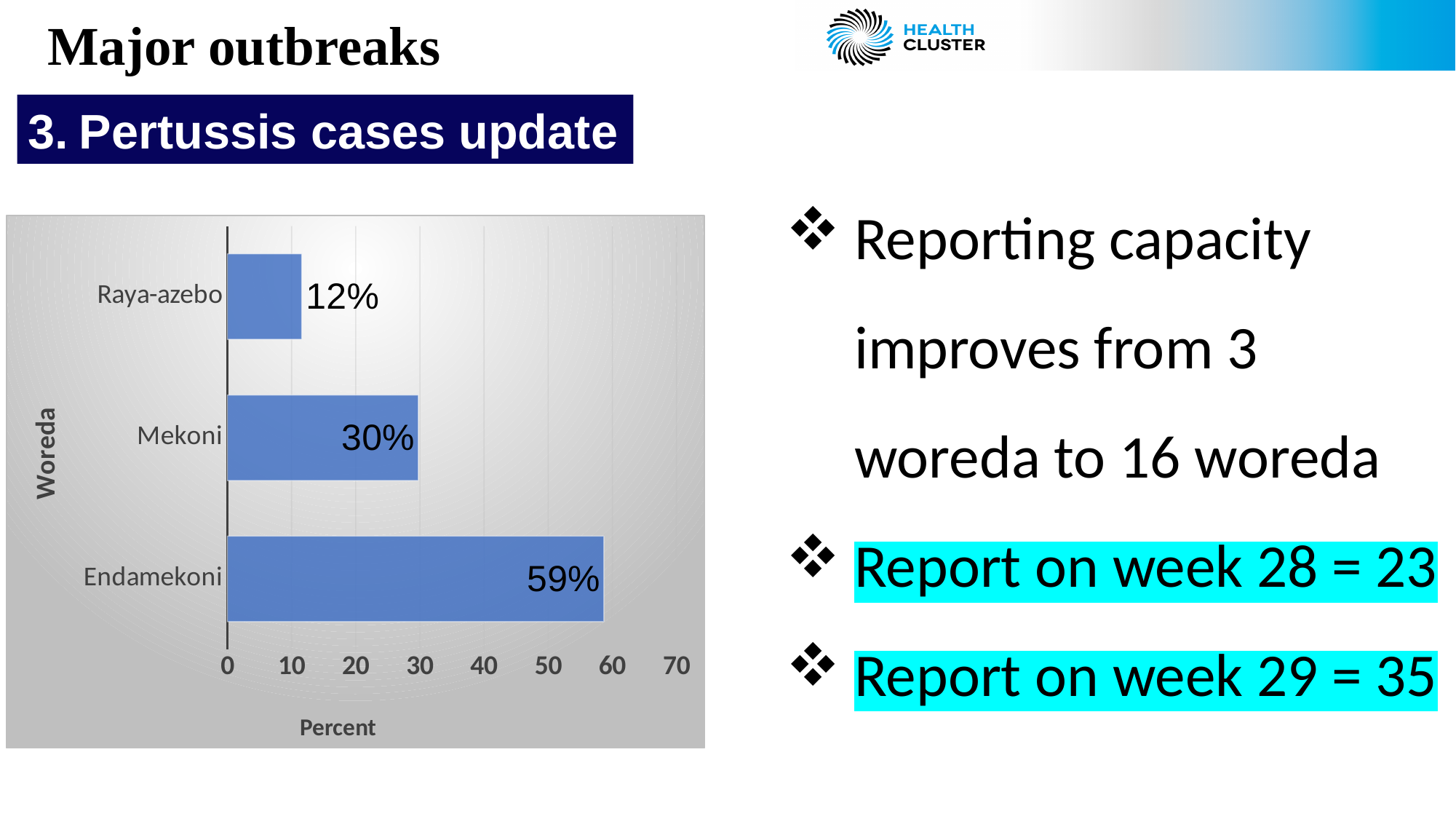
Which woreda has the highest percent? Endamekoni What is the value for Raya-azebo? 12% Which woreda has the lowest percent? Raya-azebo What is the difference between the values for Mekoni and Raya-azebo? 18% What is the value for Mekoni? 30% Is the value for Endamekoni greater or less than 50? greater What kind of chart is shown on the slide? bar chart What is the value for Endamekoni? 59% How many woredas are shown in the chart? 3 What is the difference between the values for Endamekoni and Mekoni? 29% What is the label of the horizontal axis of the chart? Percent Which is larger, the value for Mekoni or the value for Raya-azebo? Mekoni